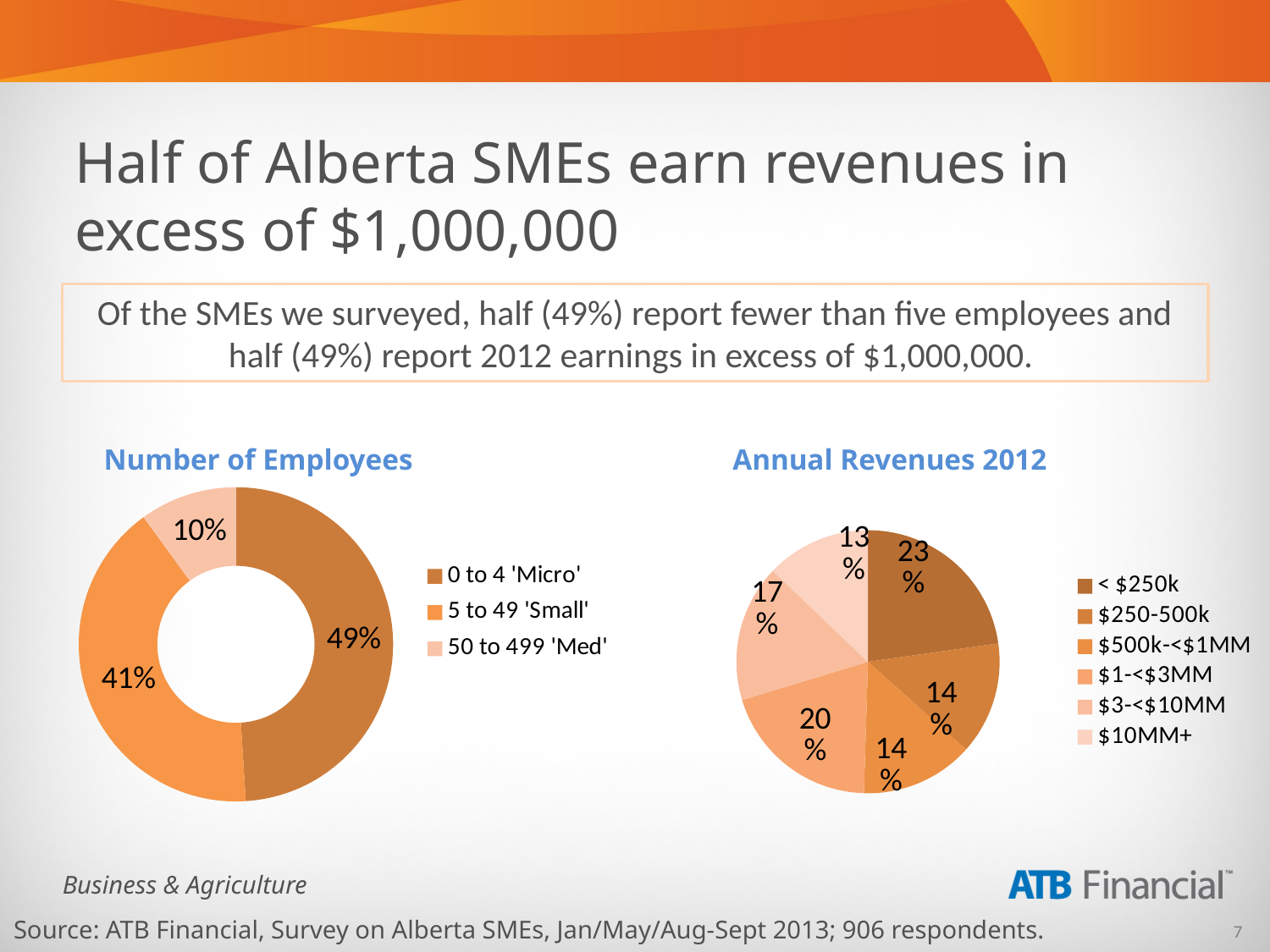
In the Annual Revenues 2012 chart, which is larger: the $3-<$10MM share or the $10MM+ share? $3-<$10MM What kind of chart is the Number of Employees chart? Donut chart What kind of chart is the Annual Revenues 2012 chart? Pie chart How many revenue categories does the legend of the Annual Revenues 2012 chart list? 6 In the Number of Employees chart, what share of SMEs have 0 to 4 'Micro' employees? 49% In the Annual Revenues 2012 chart, what share of SMEs earned less than $250k? 23% In the Number of Employees chart, which category has the largest share? 0 to 4 'Micro' How many categories does the Number of Employees chart show? 3 In the Annual Revenues 2012 chart, which revenue category has the smallest share? $10MM+ In the Number of Employees chart, what is the difference between the 0 to 4 'Micro' share and the 5 to 49 'Small' share? 8% In the Number of Employees chart, what share of SMEs have 50 to 499 'Med' employees? 10% In the Annual Revenues 2012 chart, what share of SMEs earned $1-<$3MM? 20%